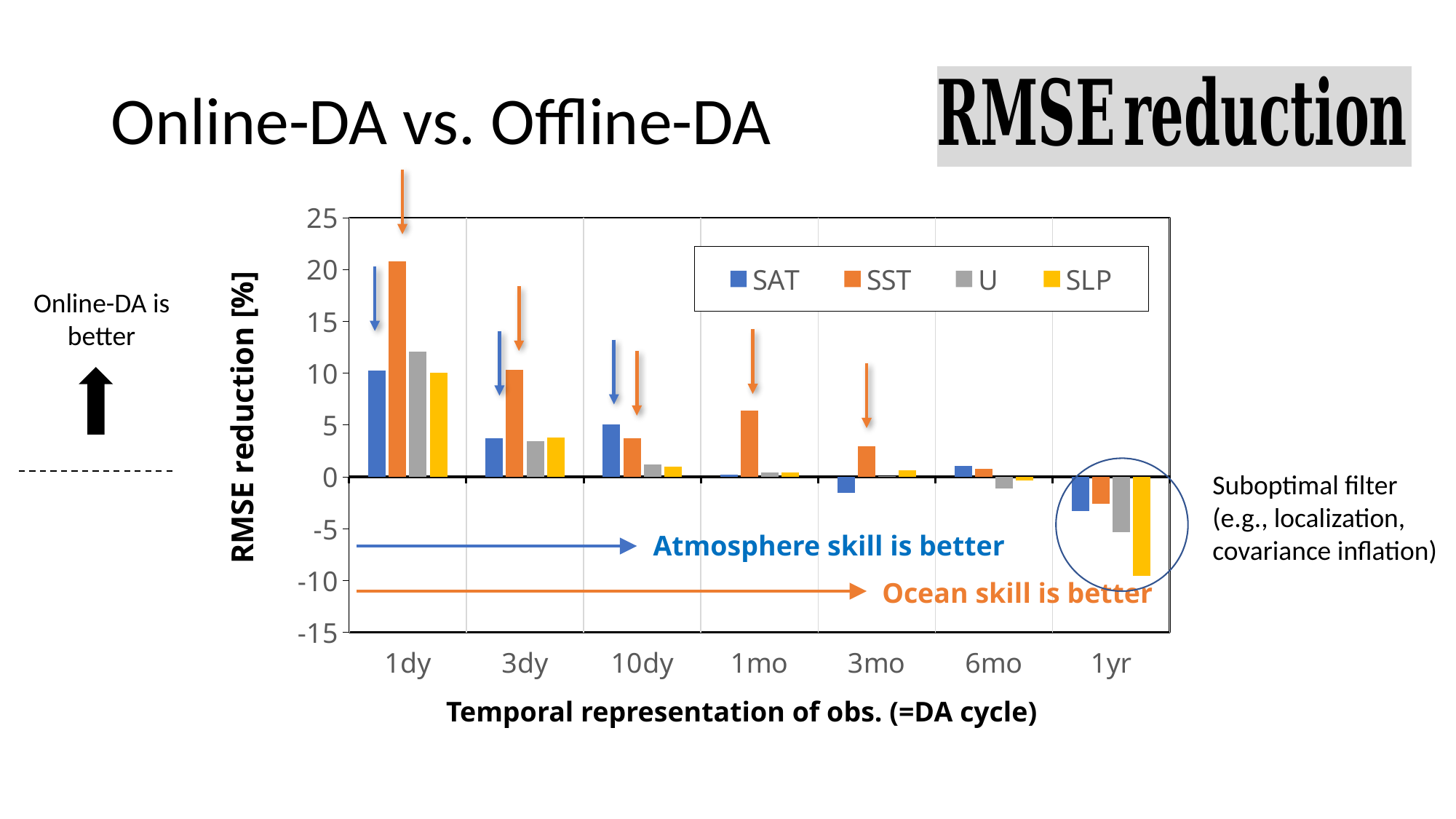
For which category is the SLP value lowest? 1yr How many series does the legend list? 4 At 10dy, which is larger, the SAT value or the SST value? SAT Is the SST value for 3dy greater or less than 5? greater At 1dy, which is larger, the U value or the SLP value? U Do the SST values generally rise or fall from 1dy to 1yr along the x axis? fall How many categories are shown on the x axis? 7 For which category is the SST value highest? 1dy Is the SLP value for 1yr greater or less than -5? less Is the SST value for 1dy greater or less than 15? greater What kind of chart is shown on the slide? bar chart